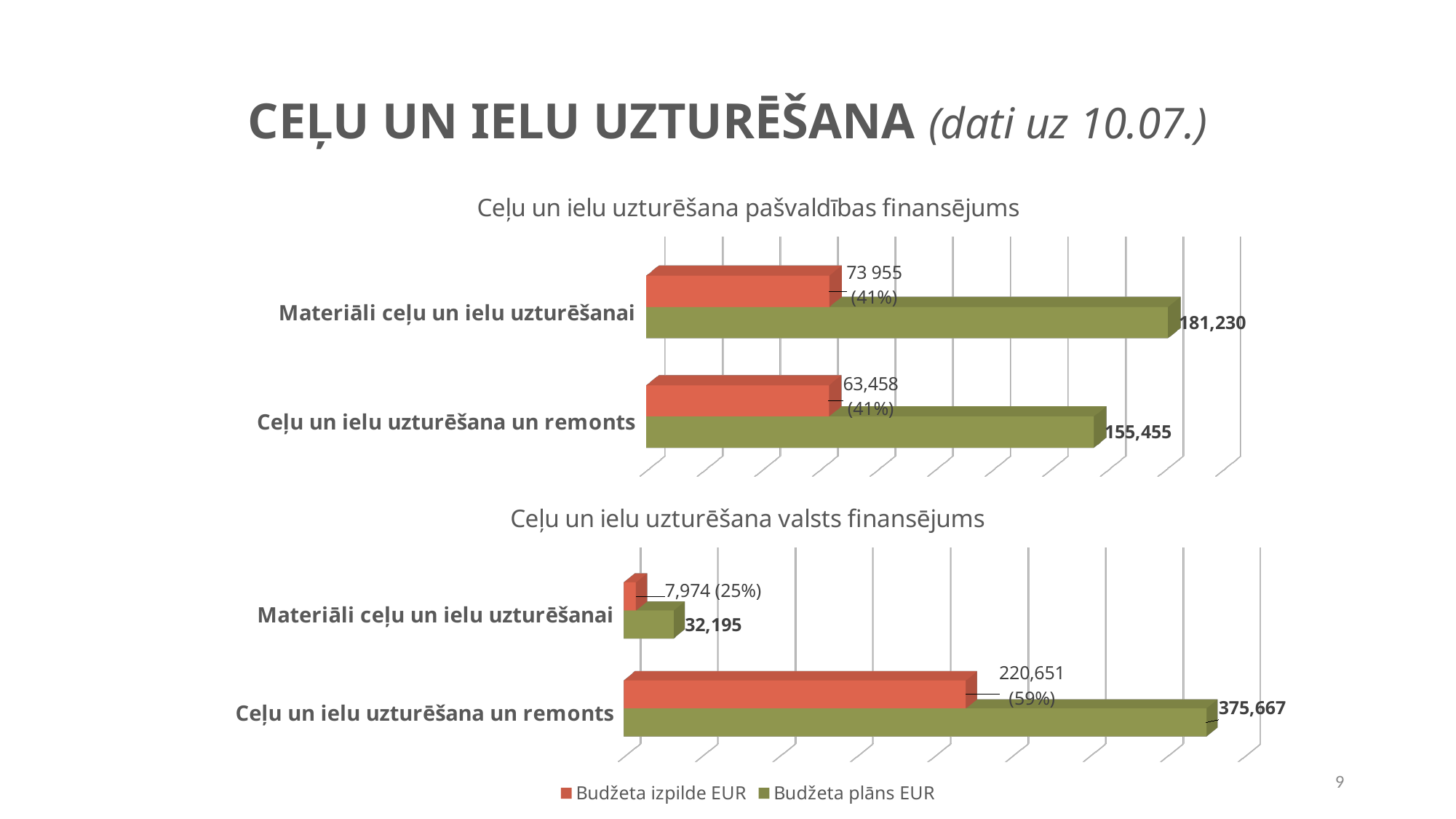
In the top chart (Ceļu un ielu uzturēšana pašvaldības finansējums), what is the Budžeta plāns EUR value for Materiāli ceļu un ielu uzturēšanai? 181,230 In the bottom chart (Ceļu un ielu uzturēšana valsts finansējums), what is the difference between the Budžeta plāns EUR and Budžeta izpilde EUR values for Ceļu un ielu uzturēšana un remonts? 155,016 In the top chart (Ceļu un ielu uzturēšana pašvaldības finansējums), what is the Budžeta izpilde EUR value for Ceļu un ielu uzturēšana un remonts? 63,458 What type of chart is the bottom chart (Ceļu un ielu uzturēšana valsts finansējums)? bar chart In the top chart (Ceļu un ielu uzturēšana pašvaldības finansējums), which category has the higher Budžeta plāns EUR value? Materiāli ceļu un ielu uzturēšanai In the top chart (Ceļu un ielu uzturēšana pašvaldības finansējums), what is the difference between the Budžeta plāns EUR and Budžeta izpilde EUR values for Materiāli ceļu un ielu uzturēšanai? 107,275 In the bottom chart (Ceļu un ielu uzturēšana valsts finansējums), which category has the lowest Budžeta izpilde EUR value? Materiāli ceļu un ielu uzturēšanai How many categories does the top chart (Ceļu un ielu uzturēšana pašvaldības finansējums) show? 2 In the bottom chart (Ceļu un ielu uzturēšana valsts finansējums), what percentage is shown next to the Budžeta izpilde EUR value for Materiāli ceļu un ielu uzturēšanai? 25% In the bottom chart (Ceļu un ielu uzturēšana valsts finansējums), is the Budžeta izpilde EUR value for Ceļu un ielu uzturēšana un remonts larger or smaller than the Budžeta plāns EUR value for Materiāli ceļu un ielu uzturēšanai? larger How many series does the legend at the bottom of the slide list? 2 In the bottom chart (Ceļu un ielu uzturēšana valsts finansējums), what is the Budžeta plāns EUR value for Ceļu un ielu uzturēšana un remonts? 375,667